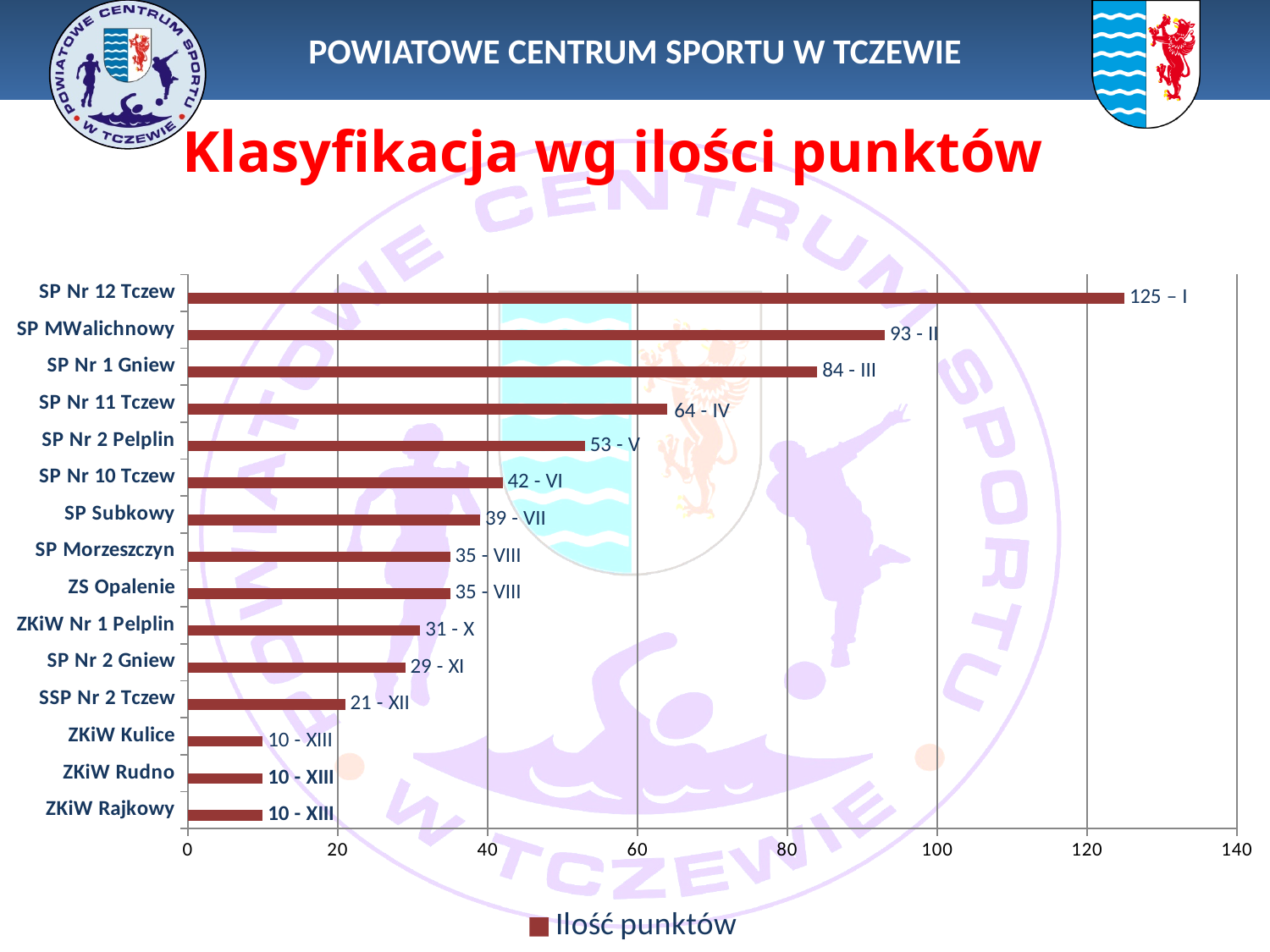
What is the difference in points between SP Nr 12 Tczew and SP MWalichnowy? 32 Which has more points, SP Nr 10 Tczew or SP Subkowy? SP Nr 10 Tczew What is the value for SSP Nr 2 Tczew? 21 What is the value for SP Nr 11 Tczew? 64 How many points does SP Nr 12 Tczew have according to the chart? 125 How many schools are listed on the chart? 15 What is the legend entry of the chart? Ilość punktów How many points does SP MWalichnowy have? 93 Which school has the highest number of points? SP Nr 12 Tczew What type of chart is shown on the slide? bar chart What is the difference in points between SP Nr 1 Gniew and SP Nr 2 Pelplin? 31 How many series does the legend list? 1